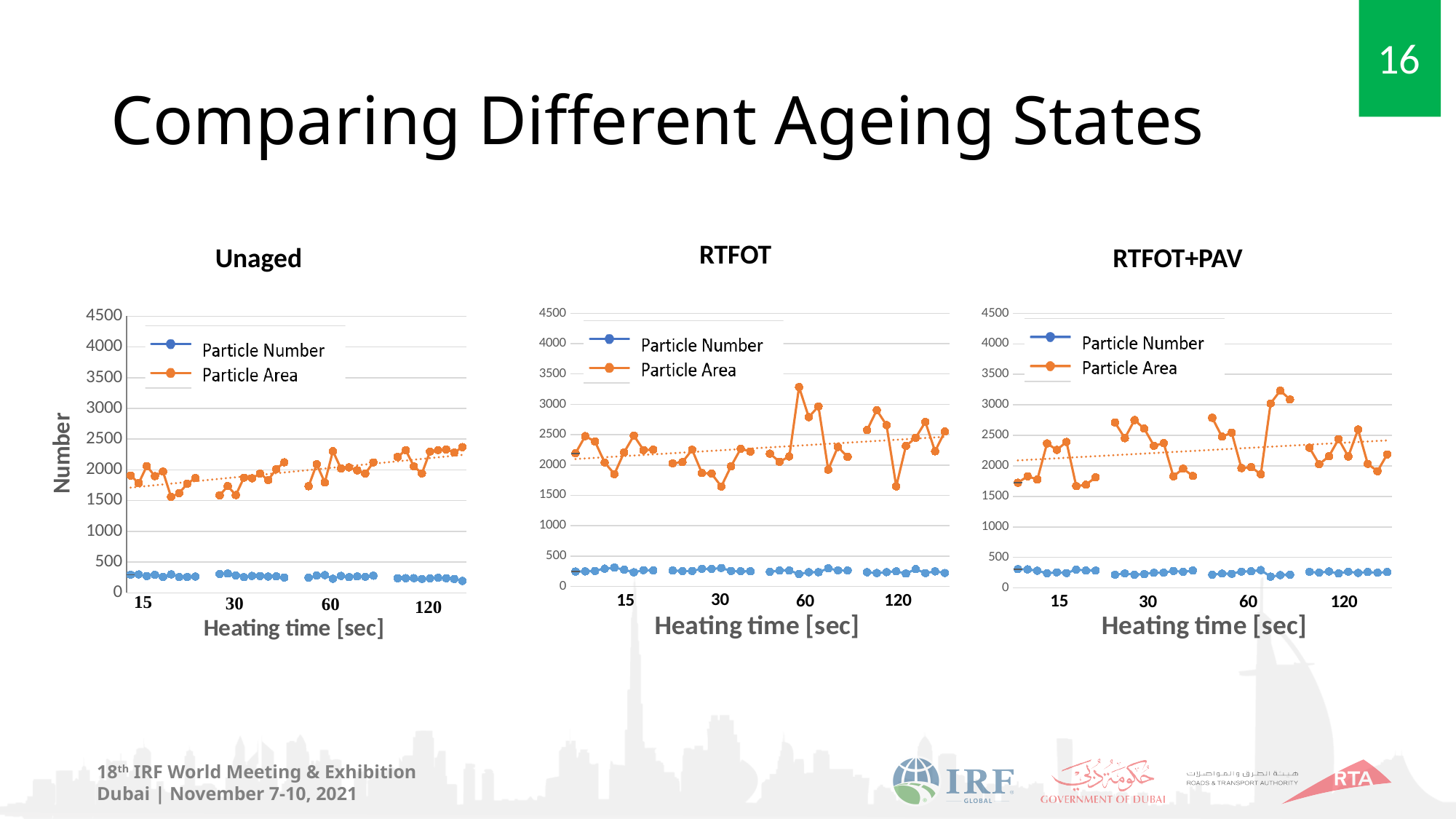
In the RTFOT+PAV chart, are the Particle Number values greater or less than 500? less How many series does the legend of the RTFOT chart list? 2 In the Unaged chart, which series has the higher values, Particle Number or Particle Area? Particle Area In the Unaged chart, are the Particle Area values greater or less than 1000? greater In the Unaged chart, does the dotted trend line for Particle Area rise or fall with heating time? rise In the RTFOT chart, is the highest Particle Area value greater or less than 3000? greater How many heating time labels are shown on the x axis of the RTFOT chart? 4 What kind of chart is the Unaged chart? line chart What is the maximum value shown on the y axis of the RTFOT+PAV chart? 4500 What are the two series named in the legend of the RTFOT+PAV chart? Particle Number and Particle Area